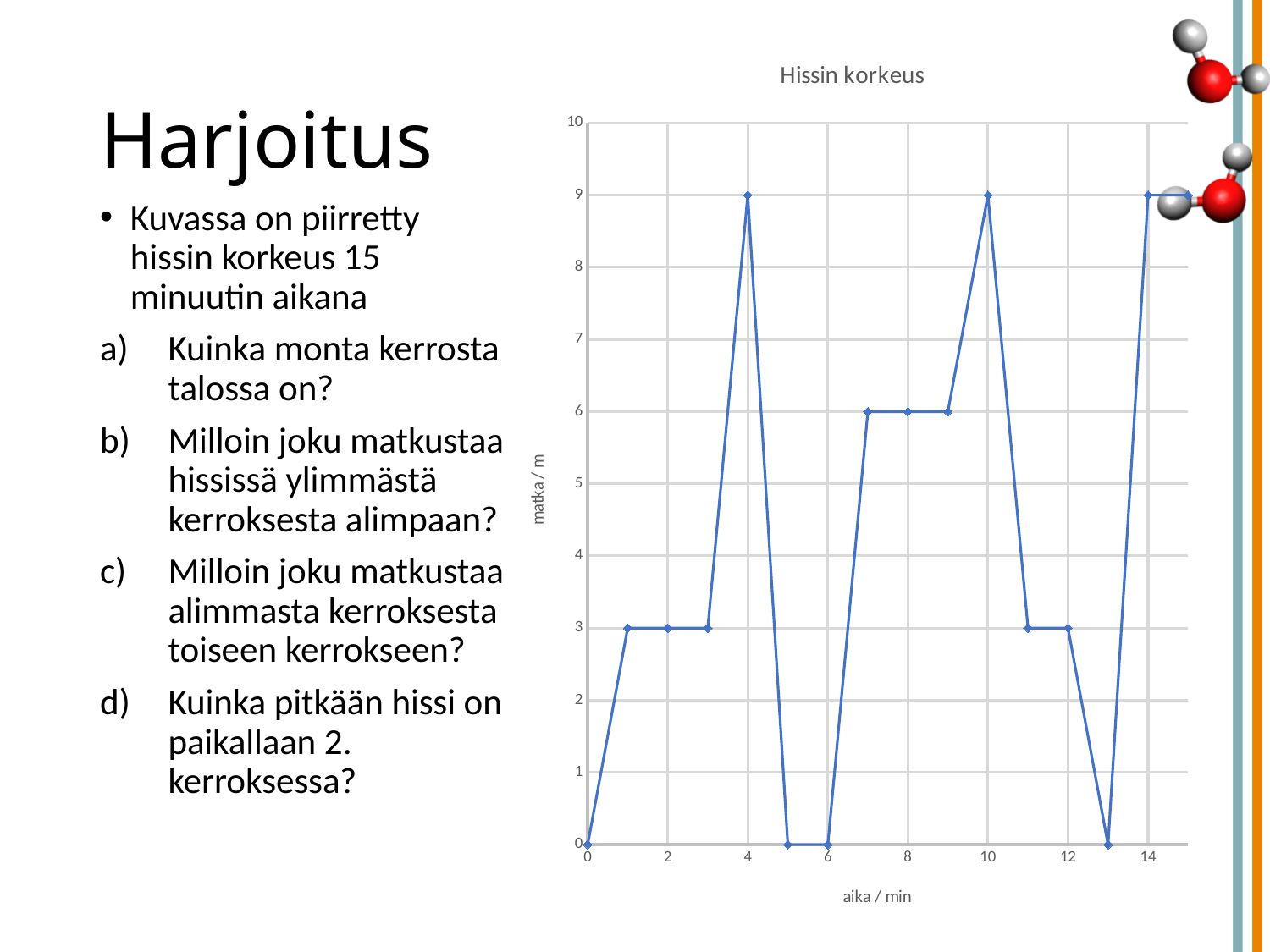
Which is larger, the value at aika 8 min or the value at aika 2 min? aika 8 min Does the value rise or fall between aika 4 min and aika 5 min? fall What is the value of matka / m at aika 4 min? 9 What is the difference between the value at aika 10 min and the value at aika 12 min? 6 What is the value of matka / m at aika 11 min? 3 What is the lowest value of matka / m on the chart? 0 What kind of chart is shown on the slide? line chart What is the highest value of matka / m reached on the chart? 9 What is the value of matka / m at aika 7 min? 6 What is the title of the chart? Hissin korkeus What is the label of the x axis? aika / min What is the value of matka / m at aika 13 min? 0